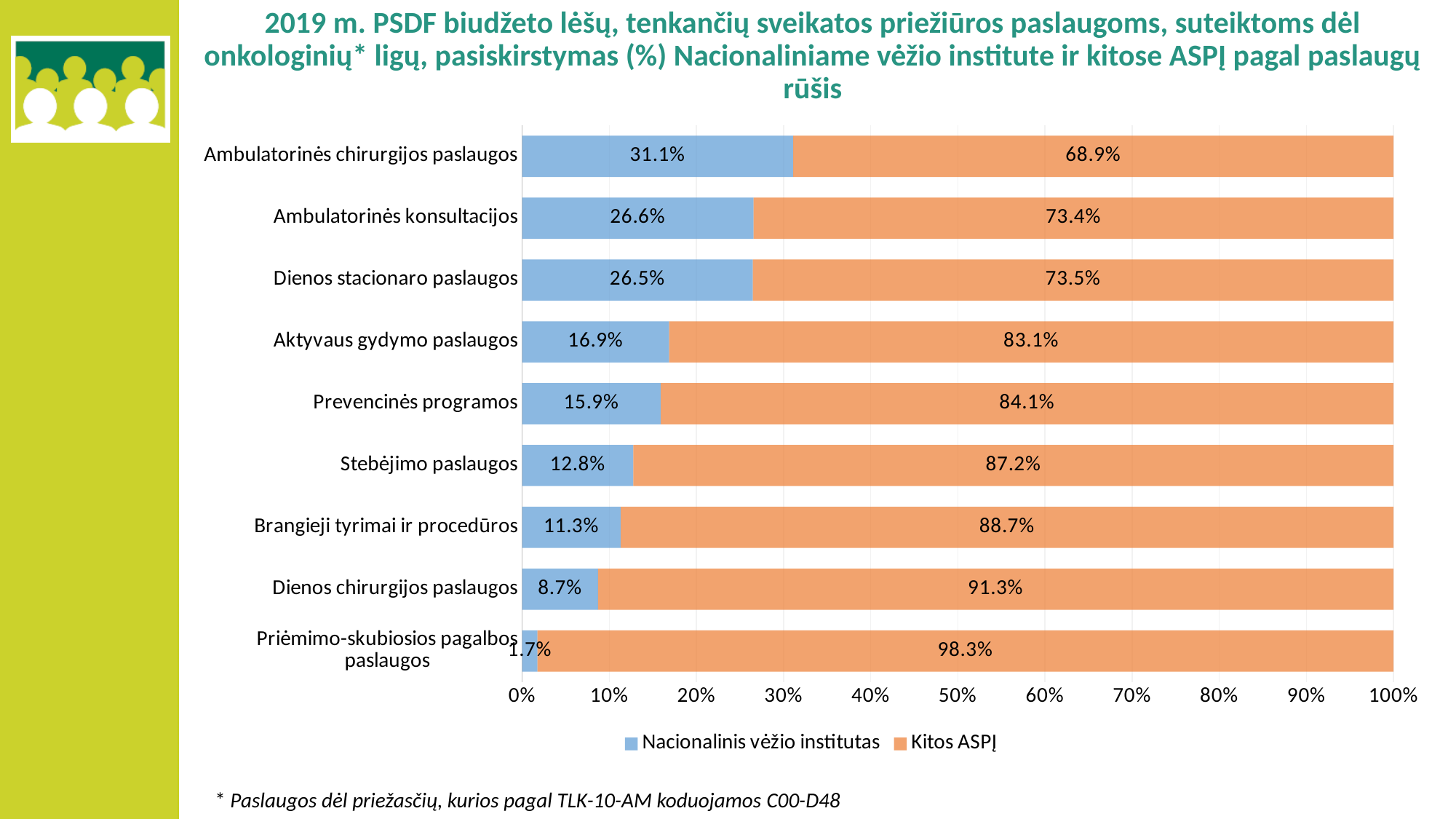
What kind of chart is shown on the slide? Stacked bar chart How many service categories are shown on the chart? 9 How many series does the legend list? 2 What is the difference between the Kitos ASPĮ value and the Nacionalinis vėžio institutas value for Aktyvaus gydymo paslaugos? 66.2% What is the value for Nacionalinis vėžio institutas for Dienos chirurgijos paslaugos? 8.7% What is the value for Nacionalinis vėžio institutas for Ambulatorinės chirurgijos paslaugos? 31.1% Which category has the lowest value for Nacionalinis vėžio institutas? Priėmimo-skubiosios pagalbos paslaugos What is the value for Kitos ASPĮ for Stebėjimo paslaugos? 87.2% Which is larger for Nacionalinis vėžio institutas: Prevencinės programos or Brangieji tyrimai ir procedūros? Prevencinės programos Which colour represents Kitos ASPĮ in the chart? Orange Which category has the highest value for Nacionalinis vėžio institutas? Ambulatorinės chirurgijos paslaugos Which category has the highest value for Kitos ASPĮ? Priėmimo-skubiosios pagalbos paslaugos